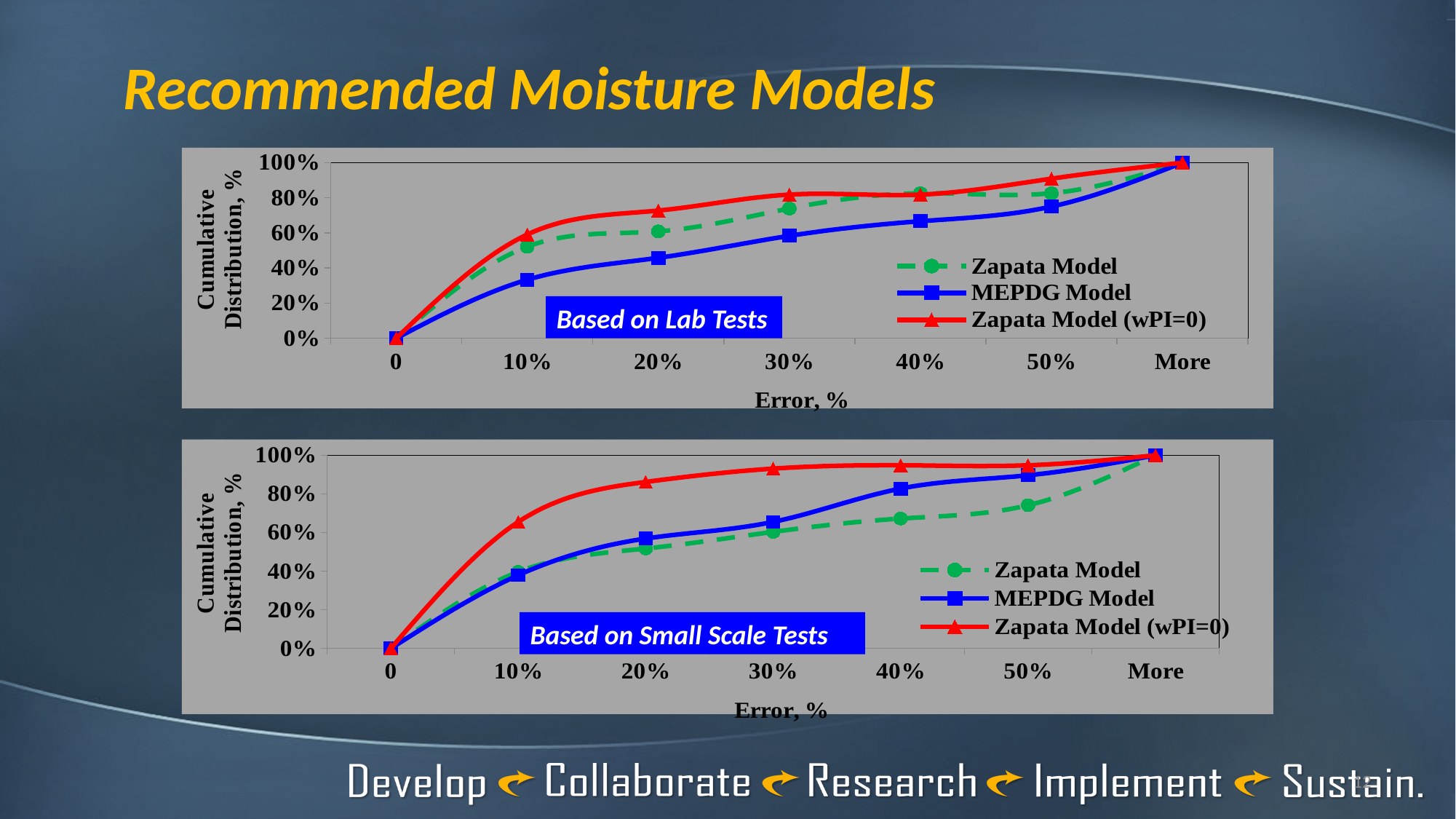
In the top chart (Based on Lab Tests), how many series does the legend list? 3 In the bottom chart (Based on Small Scale Tests), is the value for the Zapata Model at 50% error greater or less than 80%? less In the top chart (Based on Lab Tests), is the value for the MEPDG Model at 10% error greater or less than 40%? less In the top chart (Based on Lab Tests), which series is drawn in red with triangle markers? Zapata Model (wPI=0) In the top chart (Based on Lab Tests), is the value for the Zapata Model (wPI=0) at 20% error greater or less than 60%? greater In the top chart (Based on Lab Tests), at 10% error, which is larger: the MEPDG Model or the Zapata Model (wPI=0)? Zapata Model (wPI=0) In the bottom chart (Based on Small Scale Tests), at 40% error, which is larger: the MEPDG Model or the Zapata Model? MEPDG Model In the bottom chart (Based on Small Scale Tests), how many categories are shown on the x axis? 7 What kind of chart is the top chart labelled 'Based on Lab Tests'? line chart In the top chart (Based on Lab Tests), does the MEPDG Model line rise or fall as error increases along the x axis? rise What is the x-axis title of the bottom chart (Based on Small Scale Tests)? Error, %